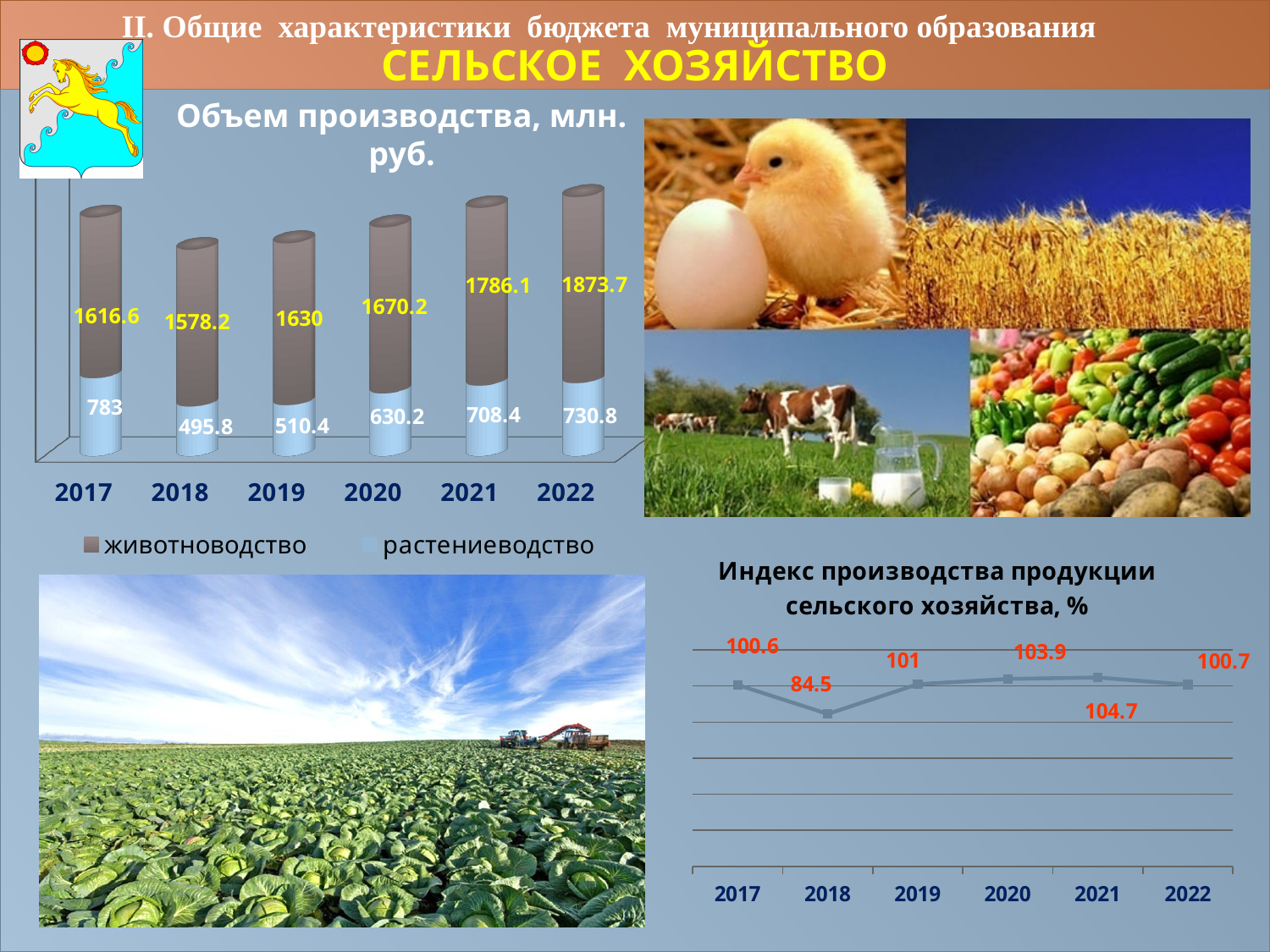
In the chart 'Объем производства, млн. руб.', what is the total of the stacked bar for 2022? 2604.5 In the chart 'Объем производства, млн. руб.', by how much did растениеводство fall from 2017 to 2018? 287.2 In the chart 'Объем производства, млн. руб.', what is the value for животноводство in 2022? 1873.7 In the chart 'Объем производства, млн. руб.', which year has the lowest value for растениеводство? 2018 In the chart 'Объем производства, млн. руб.', which year has the highest value for животноводство? 2022 In the chart 'Индекс производства продукции сельского хозяйства, %', what is the difference between the 2021 and 2018 values? 20.2 What kind of chart is 'Объем производства, млн. руб.'? Stacked bar chart In the chart 'Объем производства, млн. руб.', how many series does the legend list? 2 In the chart 'Индекс производства продукции сельского хозяйства, %', which year has the highest value? 2021 In the chart 'Объем производства, млн. руб.', what is the value for растениеводство in 2018? 495.8 In the chart 'Индекс производства продукции сельского хозяйства, %', how many years are plotted? 6 In the chart 'Индекс производства продукции сельского хозяйства, %', what is the value for 2018? 84.5